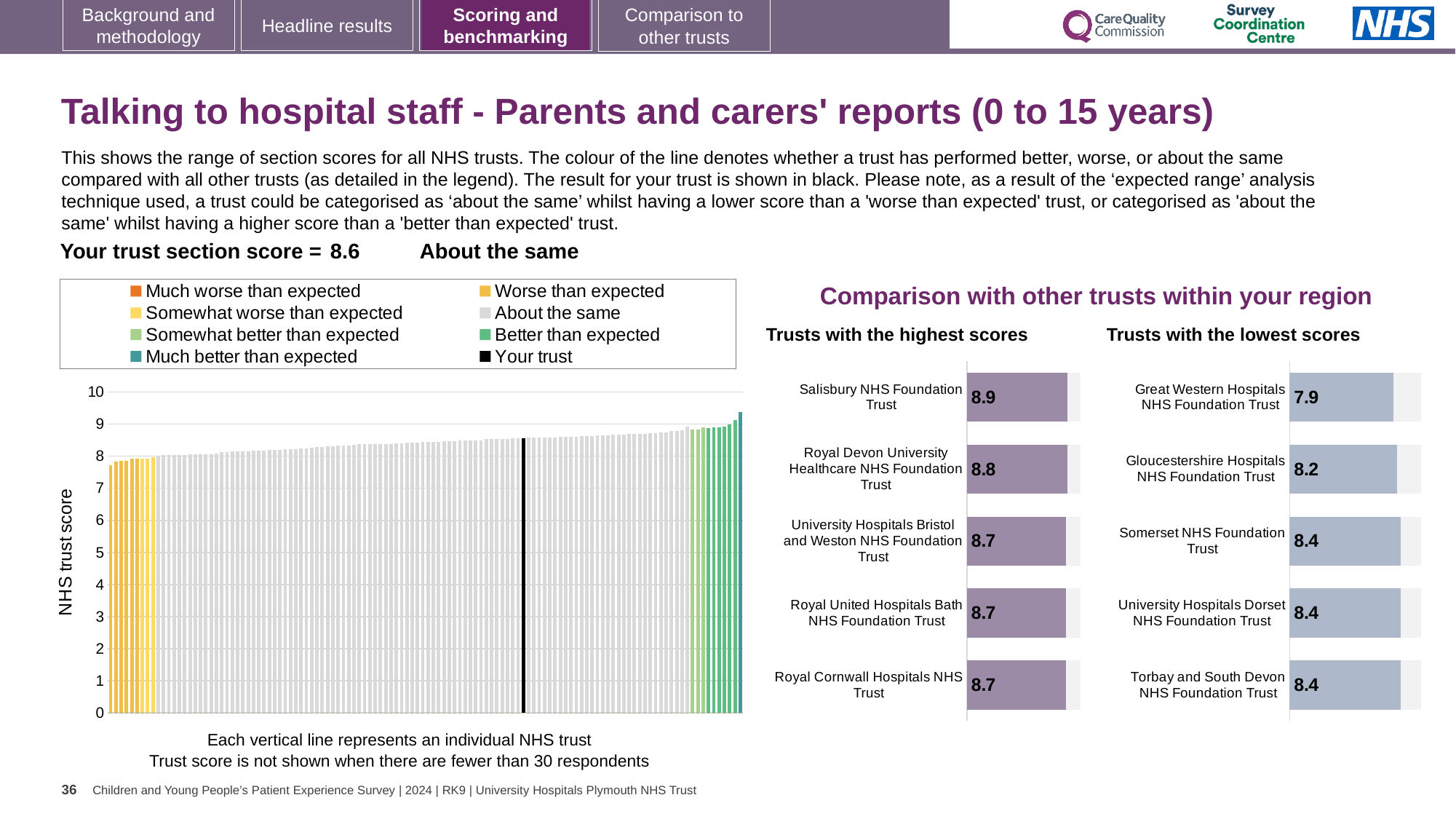
In the 'Trusts with the lowest scores' chart, what is the score for Gloucestershire Hospitals NHS Foundation Trust? 8.2 In the 'Trusts with the highest scores' chart, what is the score for Salisbury NHS Foundation Trust? 8.9 In the large 'NHS trust score' chart on the left, do the bar values rise or fall from left to right? rise In the 'Trusts with the lowest scores' chart, what is the difference between the scores of Gloucestershire Hospitals NHS Foundation Trust and Great Western Hospitals NHS Foundation Trust? 0.3 In the 'Trusts with the highest scores' chart, what is the score for Royal Devon University Healthcare NHS Foundation Trust? 8.8 How many trusts are shown in the 'Trusts with the lowest scores' chart? 5 In the 'Trusts with the highest scores' chart, which trust has the highest score? Salisbury NHS Foundation Trust In the 'Trusts with the highest scores' chart, what is the difference between the scores of Salisbury NHS Foundation Trust and Royal Cornwall Hospitals NHS Trust? 0.2 In the 'Trusts with the lowest scores' chart, which trust has the lowest score? Great Western Hospitals NHS Foundation Trust Which is larger: the score for Salisbury NHS Foundation Trust in the highest scores chart or the score for Great Western Hospitals NHS Foundation Trust in the lowest scores chart? Salisbury NHS Foundation Trust In the 'Trusts with the lowest scores' chart, what is the score for Great Western Hospitals NHS Foundation Trust? 7.9 How many entries does the legend of the large 'NHS trust score' chart on the left list? 8